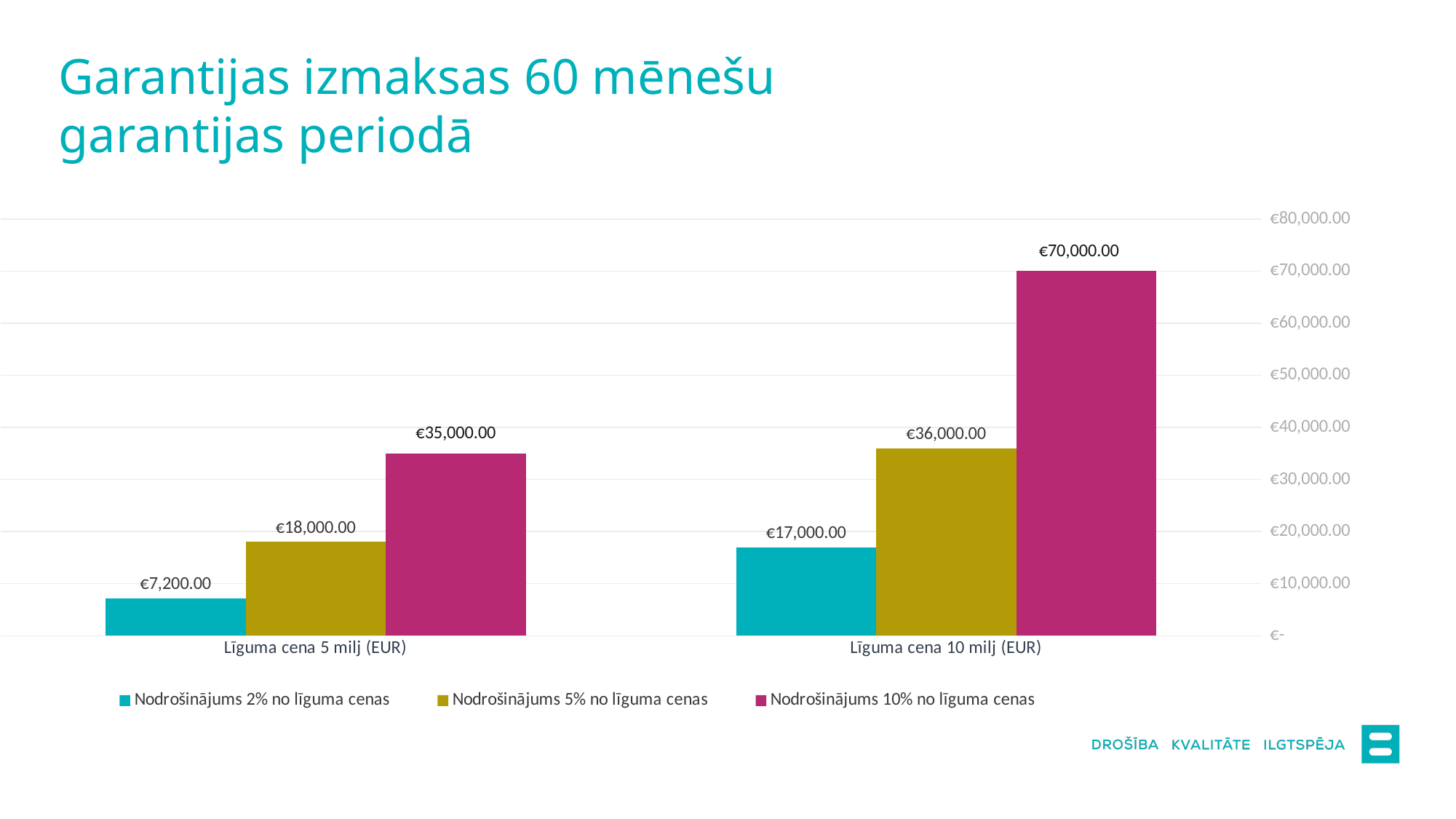
How many series does the legend list? 3 What is the value for 'Nodrošinājums 2% no līguma cenas' in the 'Līguma cena 10 milj (EUR)' category? €17,000.00 What is the value for 'Nodrošinājums 10% no līguma cenas' in the 'Līguma cena 10 milj (EUR)' category? €70,000.00 Which series has the highest value in the 'Līguma cena 10 milj (EUR)' category? Nodrošinājums 10% no līguma cenas What kind of chart is shown on the slide? bar chart What is the difference between the 'Nodrošinājums 10% no līguma cenas' values for 'Līguma cena 10 milj (EUR)' and 'Līguma cena 5 milj (EUR)'? €35,000.00 How many categories are shown on the x axis? 2 What is the value for 'Nodrošinājums 2% no līguma cenas' in the 'Līguma cena 5 milj (EUR)' category? €7,200.00 Is the value for 'Nodrošinājums 5% no līguma cenas' in 'Līguma cena 10 milj (EUR)' greater or less than €30,000.00? greater Which is larger: 'Nodrošinājums 5% no līguma cenas' for 'Līguma cena 10 milj (EUR)' or 'Nodrošinājums 10% no līguma cenas' for 'Līguma cena 5 milj (EUR)'? Nodrošinājums 5% no līguma cenas for Līguma cena 10 milj (EUR) Which series has the lowest value in the 'Līguma cena 5 milj (EUR)' category? Nodrošinājums 2% no līguma cenas What is the value for 'Nodrošinājums 5% no līguma cenas' in the 'Līguma cena 5 milj (EUR)' category? €18,000.00